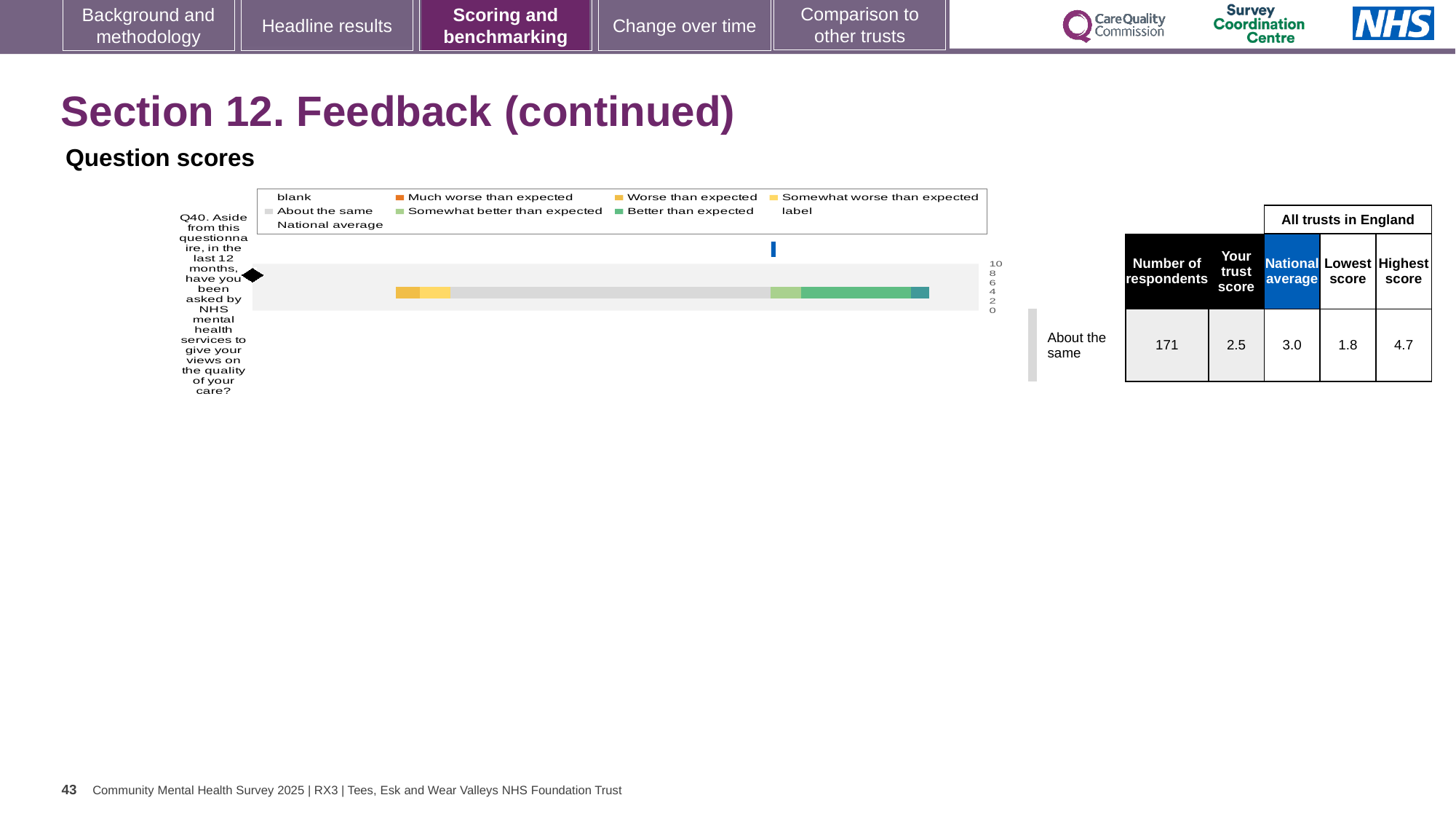
What is the highest score among all trusts in England for Q40? 4.7 Which is larger for Q40, the trust's score or the national average? National average How many questions are plotted in the Question scores chart? 1 How many respondents answered Q40? 171 What is the maximum value shown on the chart's score axis? 10 Which benchmark category is the trust's Q40 result placed in? About the same What kind of chart is used to show the Q40 question score? bar chart By how much does the national average exceed the trust's score for Q40? 0.5 What is the trust's score for Q40 shown alongside the chart? 2.5 What is the lowest score among all trusts in England for Q40? 1.8 What is the national average score for Q40? 3.0 What is the difference between the highest and lowest trust scores for Q40? 2.9